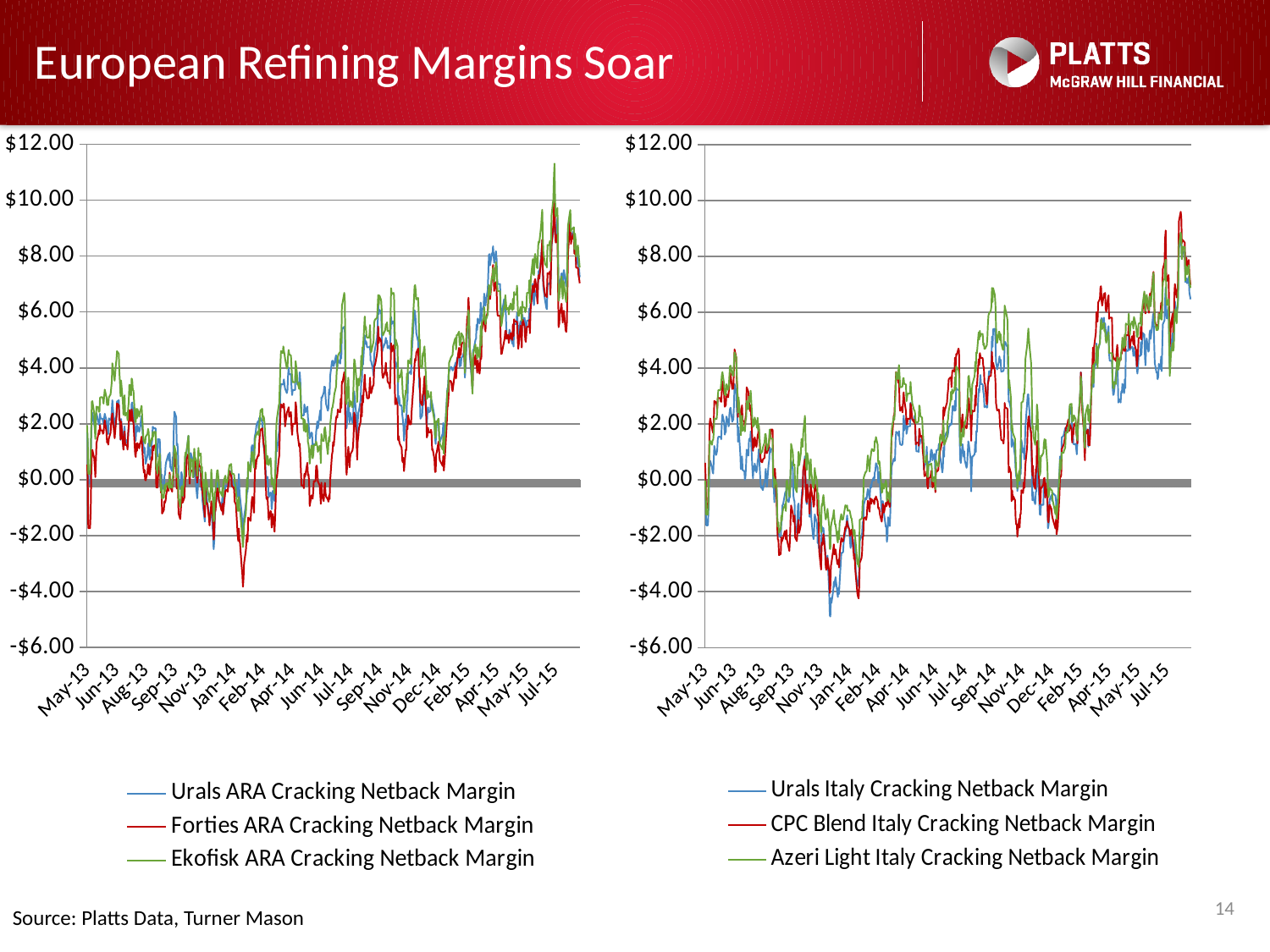
In the right chart, do the margins overall rise or fall from May-13 to Jul-15? Rise How many series does the legend of the left chart list? 3 How many date labels are shown on the x axis of the left chart? 17 What kind of chart is the right chart on the slide? Line chart In the left chart, is the peak value of the Ekofisk ARA Cracking Netback Margin around Jul-15 greater or less than $10.00? greater In the left chart, which series is drawn in green? Ekofisk ARA Cracking Netback Margin In the right chart, is the lowest value of the Urals Italy Cracking Netback Margin around Jan-14 greater or less than -$4.00? less In the right chart, which series is drawn in red? CPC Blend Italy Cracking Netback Margin How many series does the legend of the right chart list? 3 In the left chart, is the lowest value of the Forties ARA Cracking Netback Margin around Feb-14 greater or less than -$2.00? less In the left chart, do the margins overall rise or fall from May-13 to Jul-15? Rise What kind of chart is the left chart on the slide? Line chart